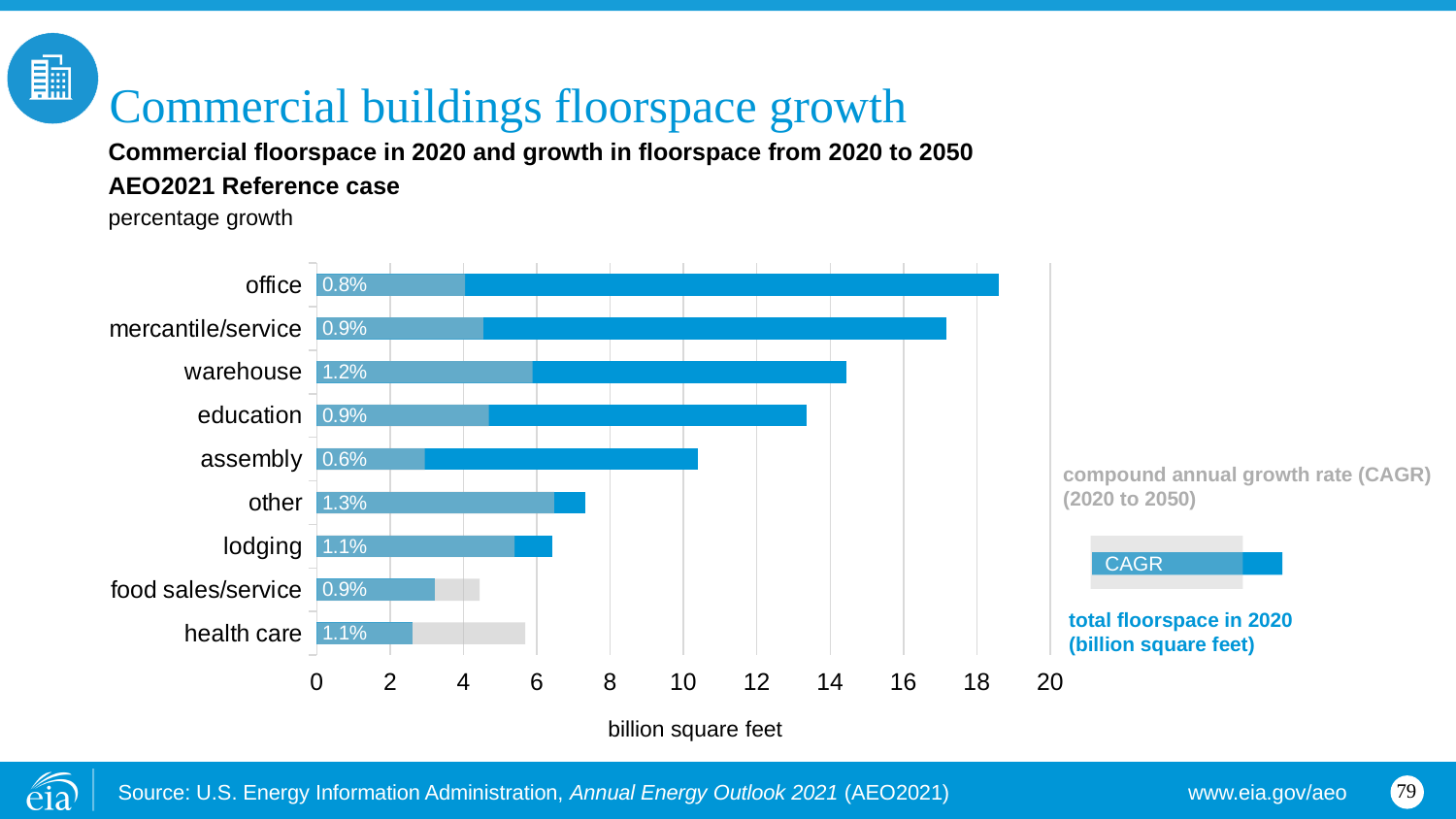
What is the compound annual growth rate (CAGR) shown for warehouse? 1.2% What is the CAGR shown for office? 0.8% Which category has the lowest CAGR label? assembly Is the total bar length for health care greater or less than 6 billion square feet? less How many building categories are shown on the chart? 9 Which has the longer total bar, office or mercantile/service? office What unit is shown on the x axis of the chart? billion square feet What kind of chart is shown on the slide? bar chart What is the CAGR shown for lodging? 1.1% Which category has the highest CAGR label? other What is the CAGR shown for assembly? 0.6% Is the total bar length for office greater or less than 18 billion square feet? greater